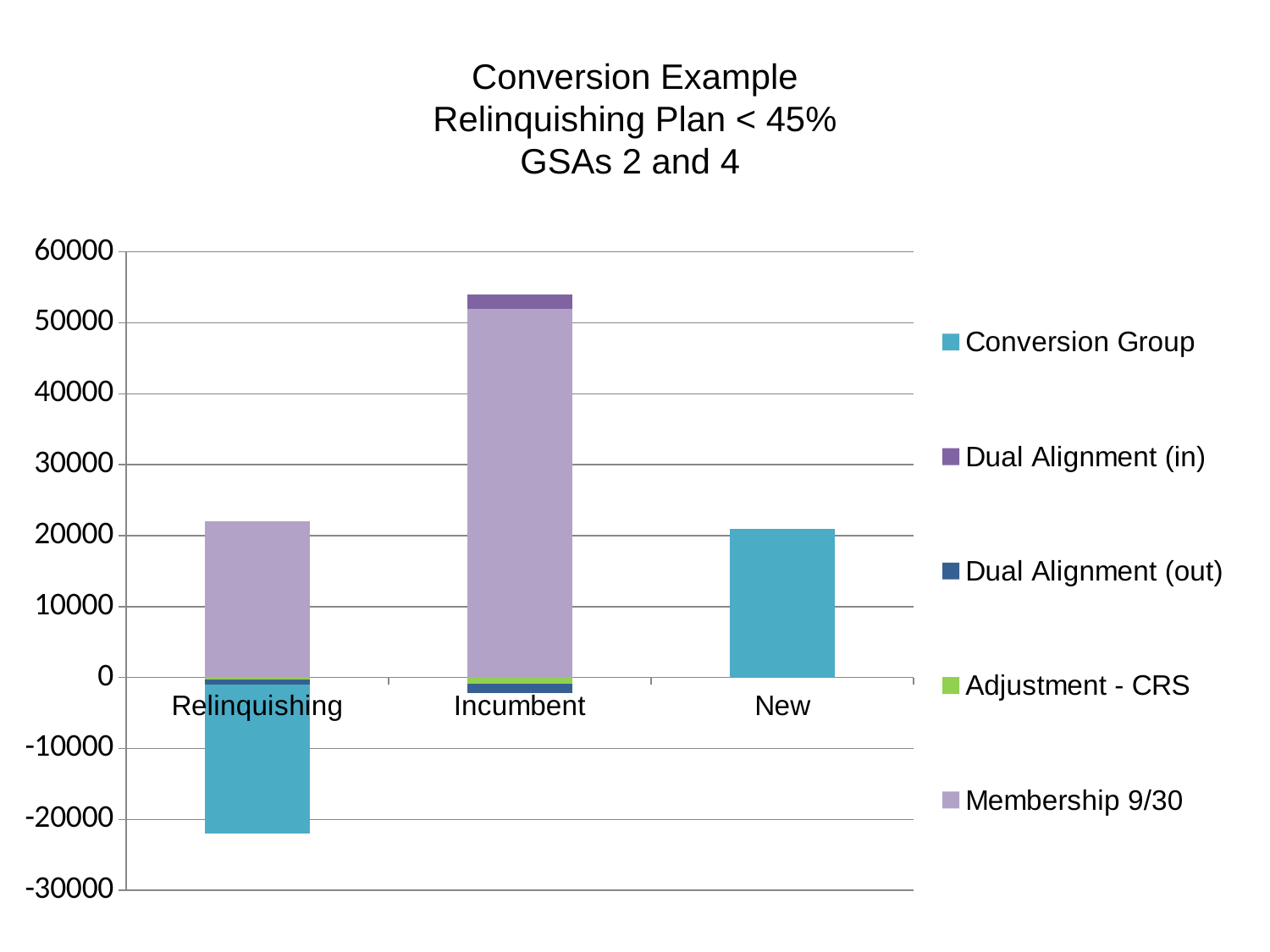
How many series does the legend list? 5 Is the Membership 9/30 value for Incumbent greater or less than 40000? greater Which category has the largest Membership 9/30 value? Incumbent How many categories are shown on the x axis? 3 Which series is shown in light purple in the legend? Membership 9/30 What kind of chart is shown on the slide? bar chart Is the Conversion Group value for New greater or less than 10000? greater Which is larger, the Membership 9/30 value for Relinquishing or for Incumbent? Incumbent Is the Conversion Group value for Relinquishing greater or less than -20000? less What is the first line of the chart title? Conversion Example Which category has a negative Conversion Group value? Relinquishing